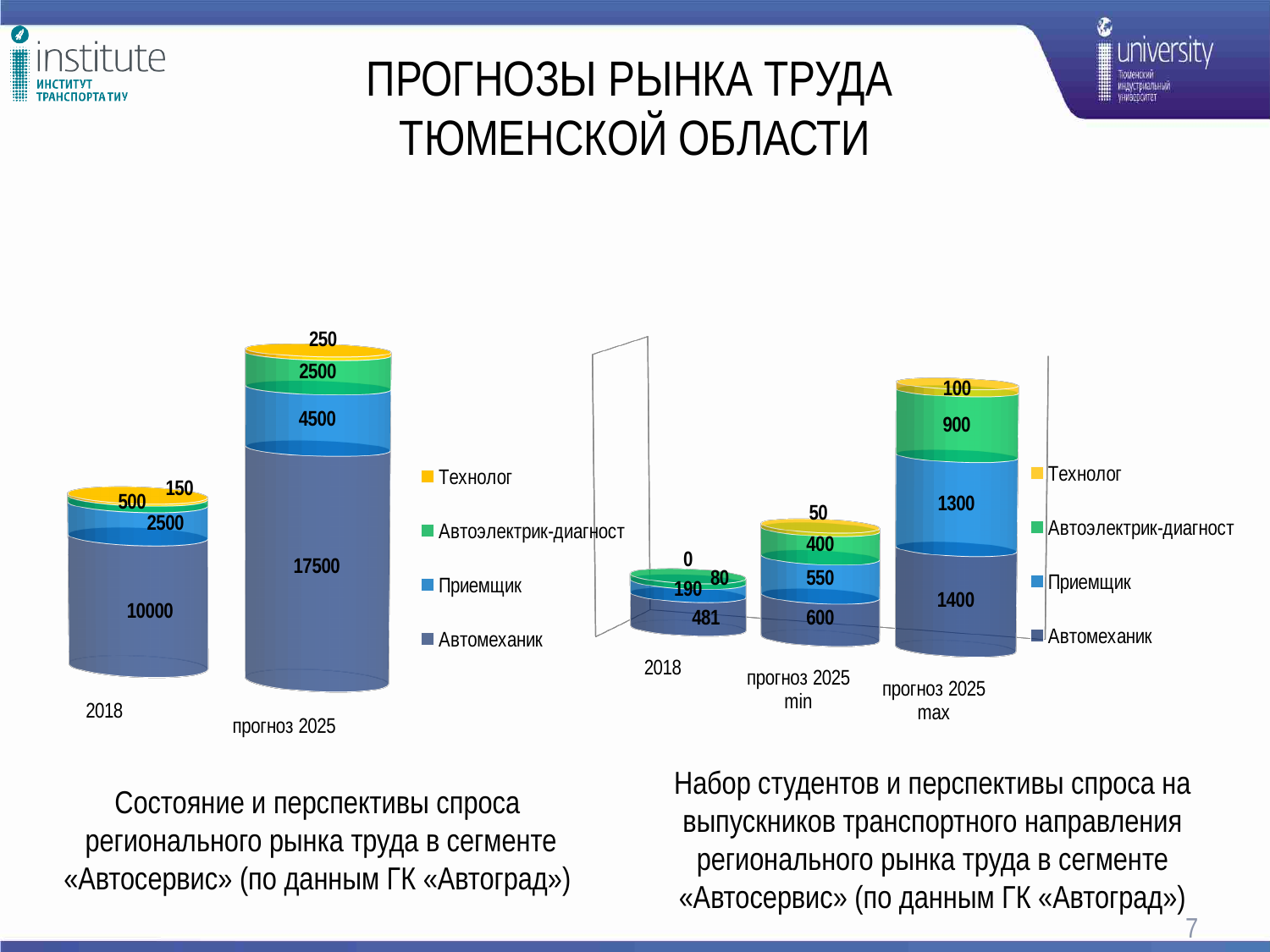
In the right chart, what is the value for Автомеханик in 2018? 481 In the right chart, what is the value for Автоэлектрик-диагност in прогноз 2025 max? 900 In the left chart, what is the value for Приемщик in прогноз 2025? 4500 In the left chart, what is the total of the stacked bar for 2018? 13150 What kind of chart is the left chart? Stacked bar chart In the left chart, what is the difference between the Автомеханик values for прогноз 2025 and 2018? 7500 In the right chart, which is larger: Приемщик in прогноз 2025 min or Приемщик in прогноз 2025 max? прогноз 2025 max In the left chart, what is the value for Автомеханик in 2018? 10000 How many series does the legend of the left chart list? 4 In the right chart, what is the total of the stacked bar for прогноз 2025 max? 3700 How many categories are shown on the x axis of the right chart? 3 In the right chart, which category has the lowest value for Технолог? 2018